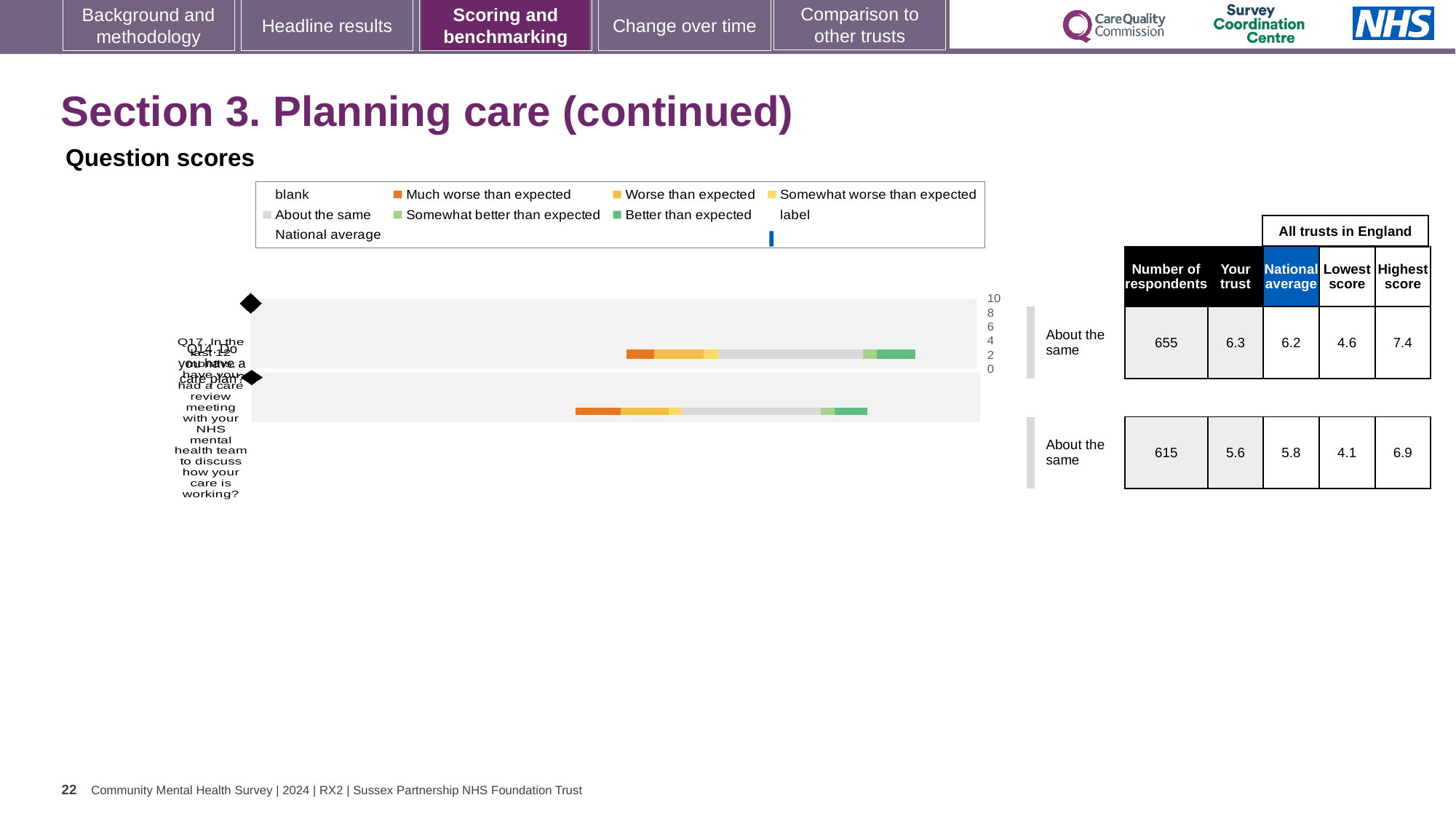
What is the lowest score among all trusts in England for Q17? 4.1 What is the 'Your trust' score for Q14 (Do you have a care plan?)? 6.3 For Q17, which is larger: the 'Your trust' score or the national average? National average What is the 'Your trust' score for Q17 (care review meeting in the last 12 months)? 5.6 What is the number of respondents for Q14 (Do you have a care plan?)? 655 How many questions (bars) are plotted in the chart? 2 What kind of chart is shown on the slide? bar chart What colour represents 'Much worse than expected' in the legend? orange What is the difference between the highest and lowest scores for Q14? 2.8 What is the maximum value shown on the chart's axis? 10 What is the national average score for Q14 (Do you have a care plan?)? 6.2 What is the highest score among all trusts in England for Q14? 7.4